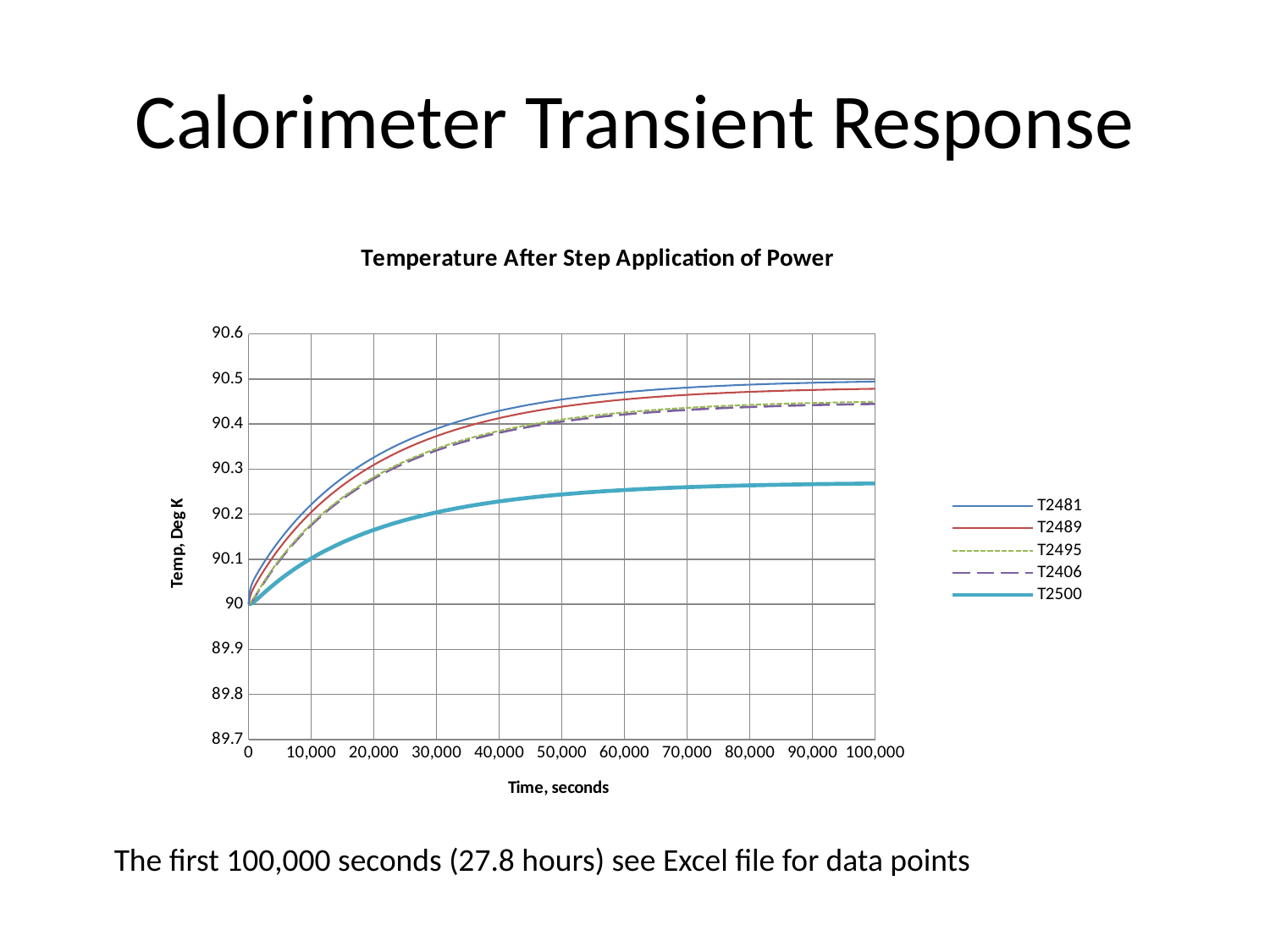
What kind of chart is shown on the slide? line chart What is the label of the y axis? Temp, Deg K Is the value for T2481 at 100,000 seconds greater or less than 90.4? greater What is the title of the chart? Temperature After Step Application of Power What is the temperature of the series at time 0? 90 Which series has the lowest temperature at 100,000 seconds? T2500 Is the value for T2500 at 20,000 seconds greater or less than 90.2? less Is the value for T2500 at 100,000 seconds greater or less than 90.3? less Do the temperature values rise or fall as time increases? rise How many series does the legend list? 5 At 100,000 seconds, which is higher: T2489 or T2500? T2489 Which series has the highest temperature at 100,000 seconds? T2481